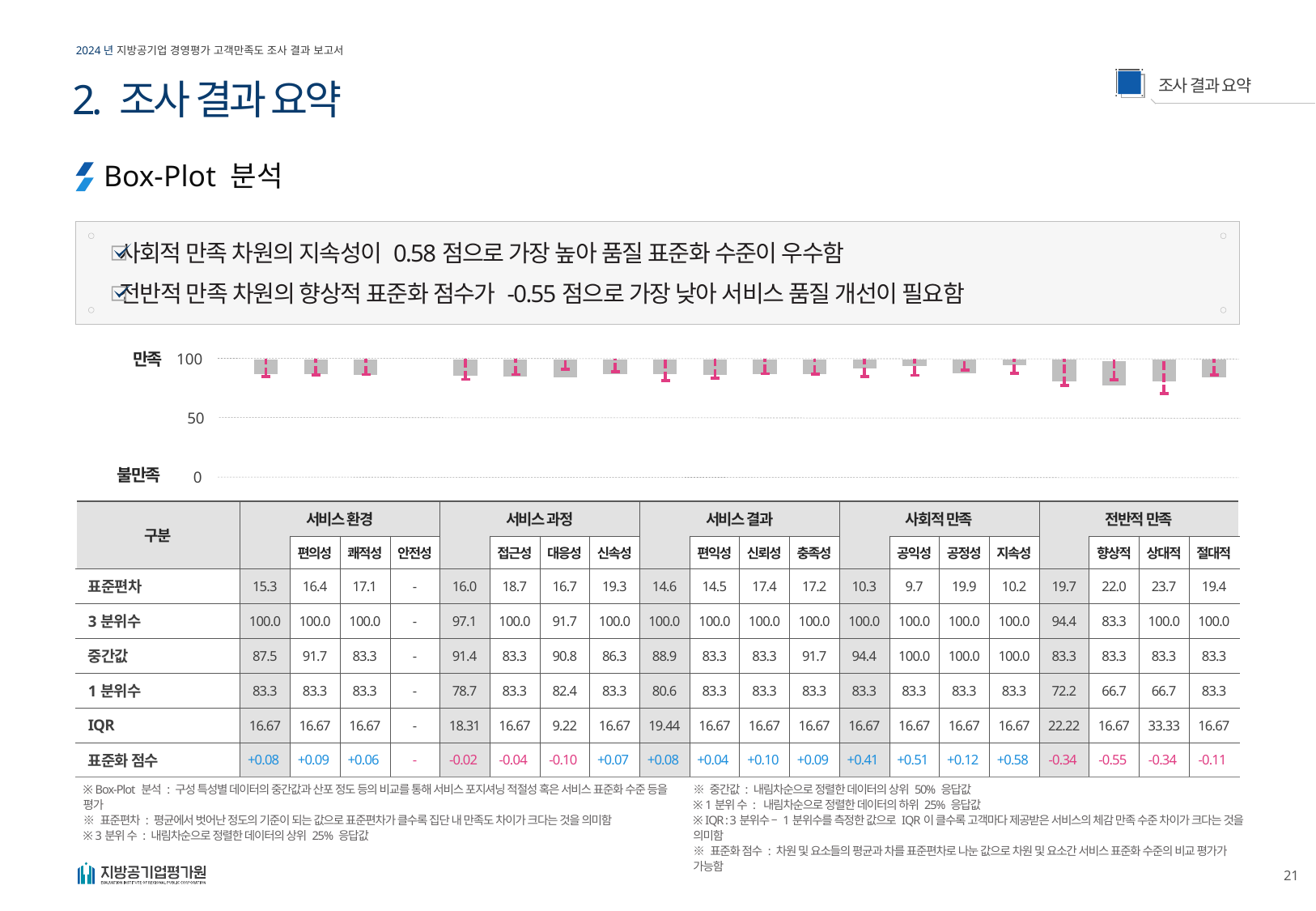
What is the IQR for 상대적 under 전반적 만족? 33.33 What is the 표준편차 for 공익성 under 사회적 만족? 9.7 What is the highest tick value shown on the vertical axis of the box-plot chart? 100 Which has the larger 중간값 under 서비스 환경: 편익성 or 쾌적성? 편익성 What is the 중간값 for 접근성 under 서비스 과정? 83.3 What is the 1 분위수 for 향상적 under 전반적 만족? 66.7 Which item has the highest 표준화 점수 in the box-plot analysis? 사회적 만족 지속성 (+0.58) Is the median for 향상적 under 전반적 만족 greater or less than 50 on the chart's axis? greater How many boxes are plotted in the box-plot chart? 19 What kind of chart is shown on the slide? Box plot Which item has the lowest 표준화 점수 in the box-plot analysis? 전반적 만족 향상적 (-0.55) What is the difference in 표준편차 between 상대적 (23.7) and 향상적 (22.0) under 전반적 만족? 1.7